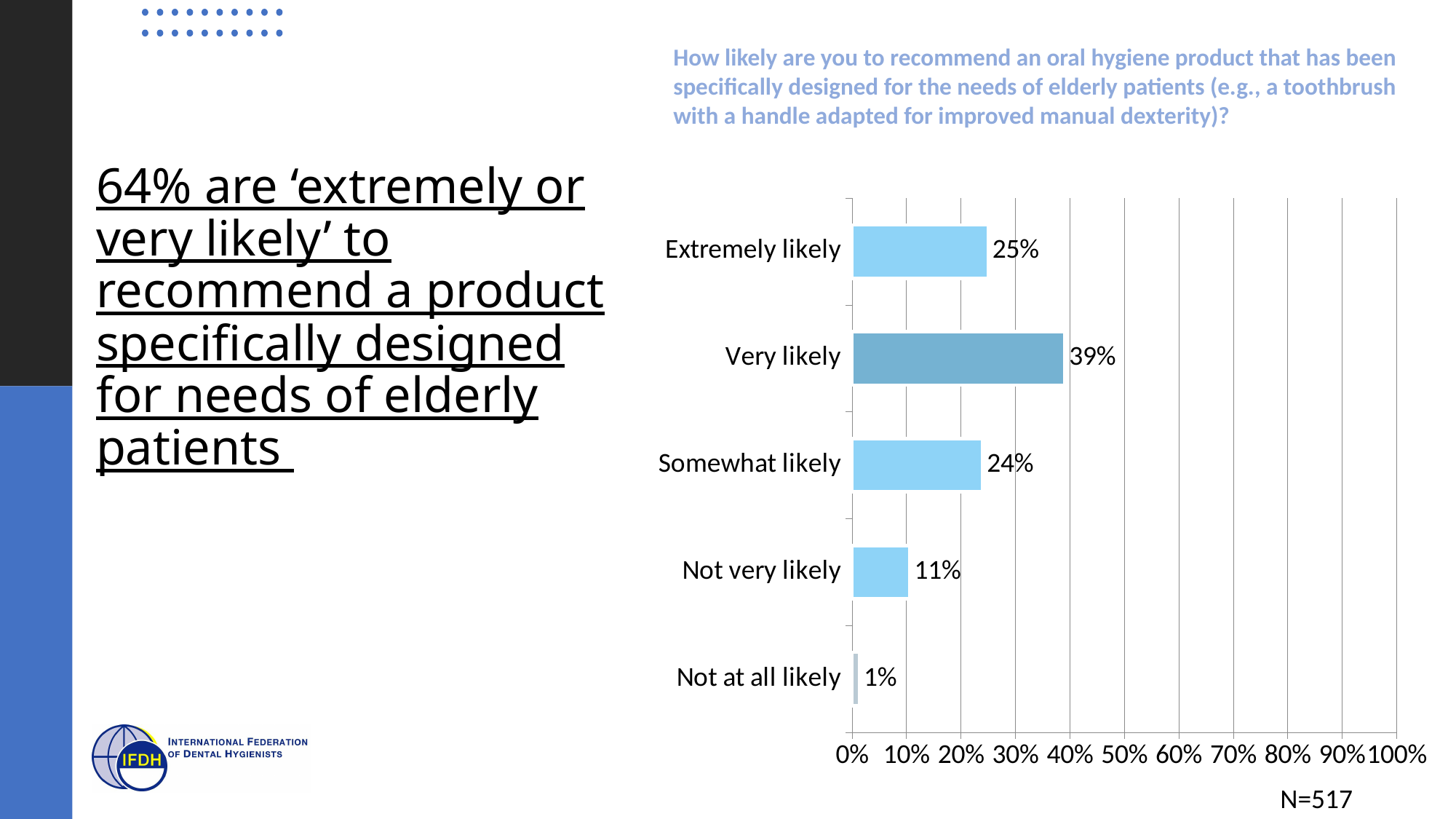
What is the value shown for 'Not very likely'? 11% What type of chart is shown on the slide? Bar chart Which is larger, the value for 'Extremely likely' or the value for 'Somewhat likely'? Extremely likely Which response category has the lowest percentage? Not at all likely Is the value for 'Very likely' greater or less than 30%? greater Which response category has the highest percentage? Very likely What percentage of respondents are 'Very likely' to recommend the product? 39% How many response categories are shown in the chart? 5 What sample size (N) is shown below the chart? N=517 What percentage of respondents are 'Extremely likely' to recommend the product? 25% What is the value shown for 'Not at all likely'? 1% What is the difference between the 'Very likely' and 'Somewhat likely' percentages? 15%